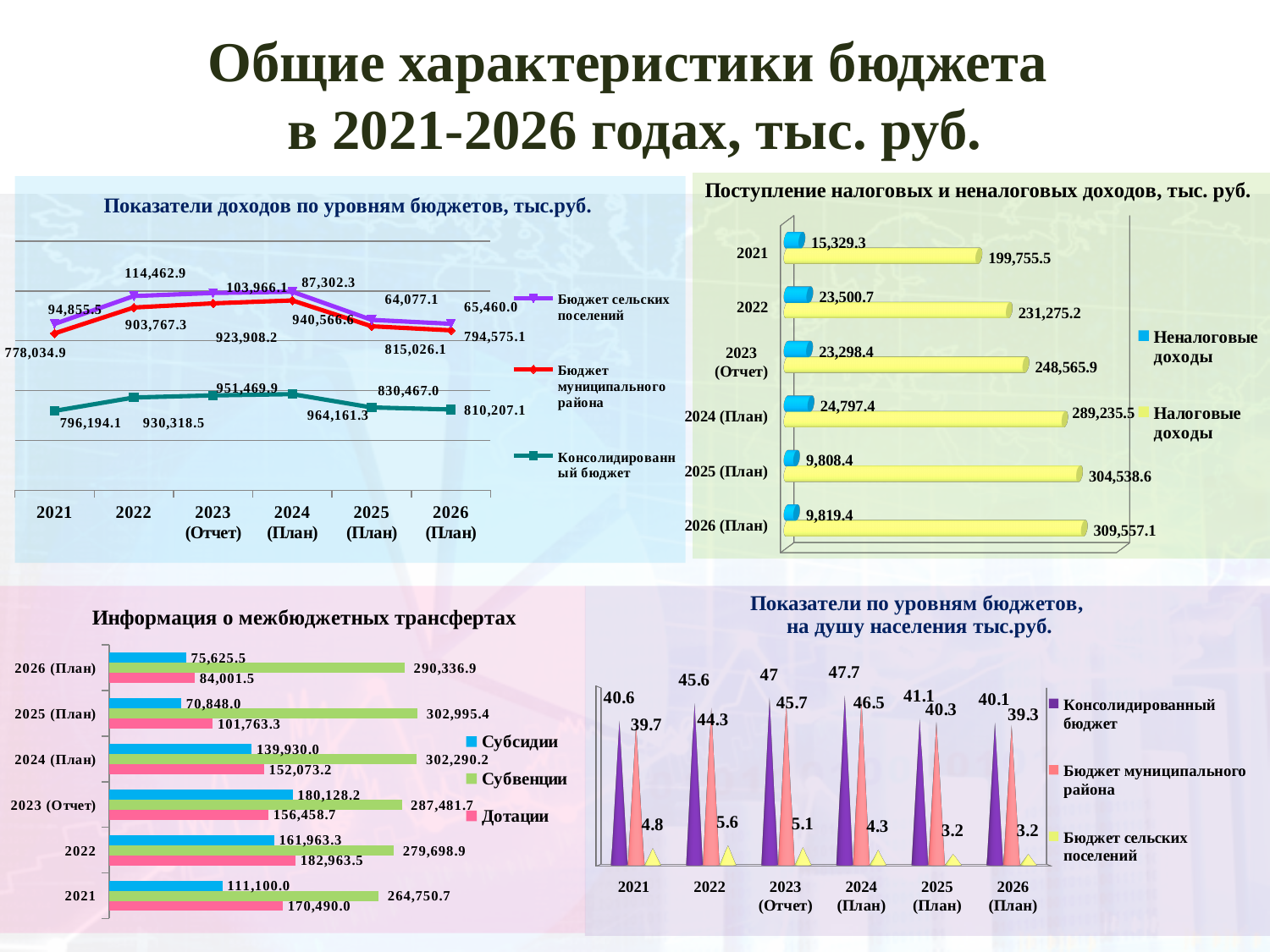
In the chart 'Показатели по уровням бюджетов, на душу населения тыс.руб.', what is the value of Консолидированный бюджет for 2024 (План)? 47.7 In the chart 'Показатели по уровням бюджетов, на душу населения тыс.руб.', which year has the highest value of Бюджет сельских поселений? 2022 What type of chart is 'Показатели доходов по уровням бюджетов, тыс.руб.'? Line chart In the chart 'Показатели доходов по уровням бюджетов, тыс.руб.', how many years are shown on the x axis? 6 In the chart 'Поступление налоговых и неналоговых доходов, тыс. руб.', which year has the highest value of Налоговые доходы? 2026 (План) In the chart 'Информация о межбюджетных трансфертах', what is the value of Субвенции for 2021? 264,750.7 In the chart 'Поступление налоговых и неналоговых доходов, тыс. руб.', what is the value of Налоговые доходы for 2024 (План)? 289,235.5 In the chart 'Информация о межбюджетных трансфертах', which is larger for 2022: Субсидии or Дотации? Дотации In the chart 'Информация о межбюджетных трансфертах', how many series does the legend list? 3 In the chart 'Поступление налоговых и неналоговых доходов, тыс. руб.', what is the difference between Неналоговые доходы in 2022 and in 2021? 8,171.4 In the chart 'Показатели доходов по уровням бюджетов, тыс.руб.', what is the value of Бюджет сельских поселений for 2022? 114,462.9 In the chart 'Информация о межбюджетных трансфертах', which year has the lowest value of Субсидии? 2025 (План)